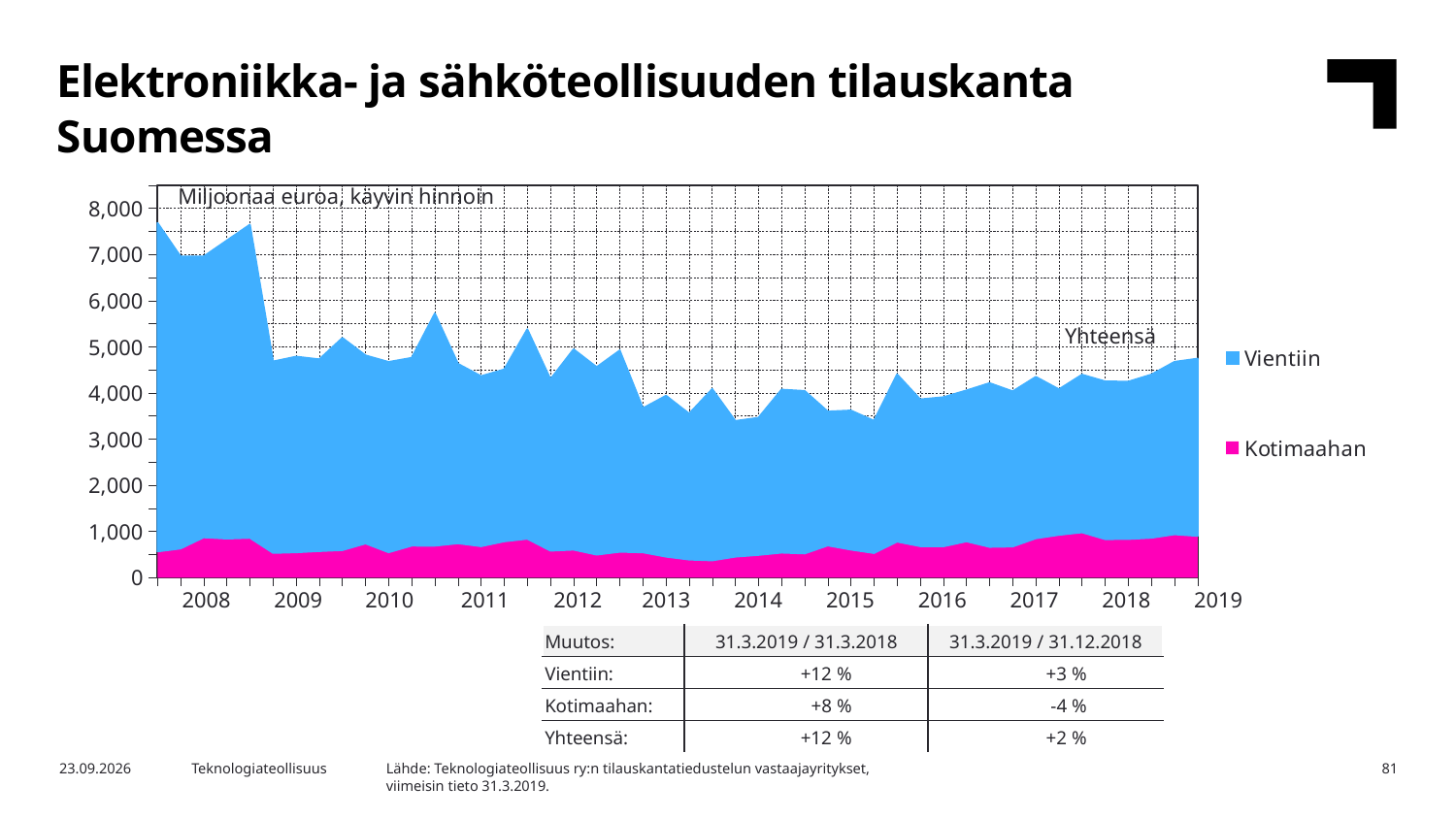
Which two series are listed in the chart legend? Vientiin and Kotimaahan Is the total order book value in 2016 greater or less than 5,000? less What unit is stated at the top of the chart? Miljoonaa euroa, käyvin hinnoin How many year labels are shown on the x axis? 12 How many series does the chart legend list? 2 Does the total order book rise or fall overall from 2008 to 2019? fall What kind of chart is shown on the slide? Area chart Does the total order book rise or fall from 2016 to 2019? rise In which year does the total order book reach its highest level? 2008 Is the Kotimaahan value in 2017 greater or less than 2,000? less Which series is larger throughout the chart, Vientiin or Kotimaahan? Vientiin